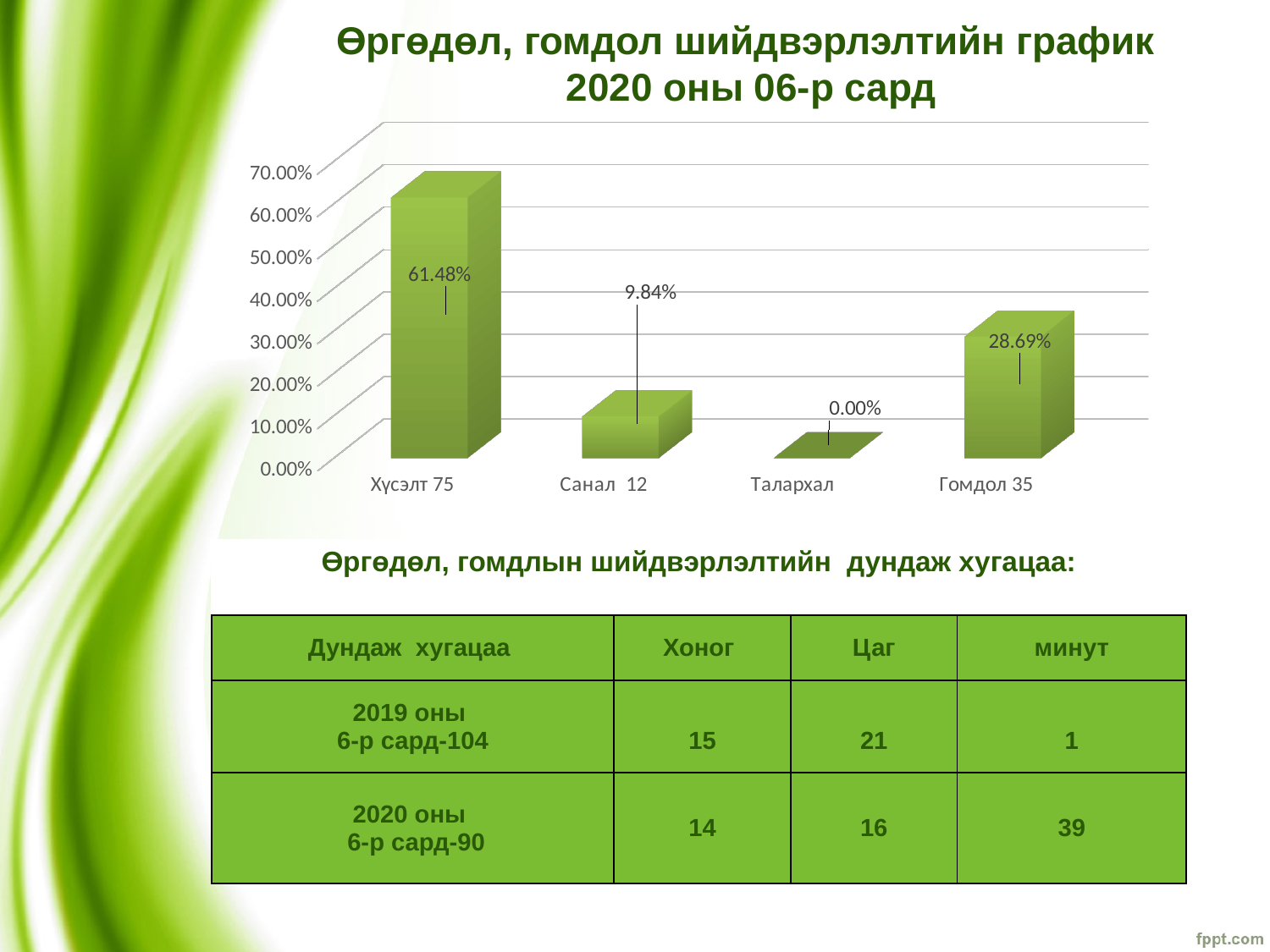
Which is larger, the value for Санал 12 or the value for Гомдол 35? Гомдол 35 What kind of chart is shown on the slide? bar chart What is the title of the chart? Өргөдөл, гомдол шийдвэрлэлтийн график 2020 оны 06-р сард What is the value shown for Хүсэлт 75? 61.48% What is the difference between the values for Хүсэлт 75 and Гомдол 35? 32.79% Which category has the highest value? Хүсэлт 75 Which category has the lowest value? Талархал What is the value shown for Гомдол 35? 28.69% What is the value shown for Талархал? 0.00% How many categories are shown on the x axis of the chart? 4 Is the value for Хүсэлт 75 greater or less than 50.00%? greater What is the value shown for Санал 12? 9.84%